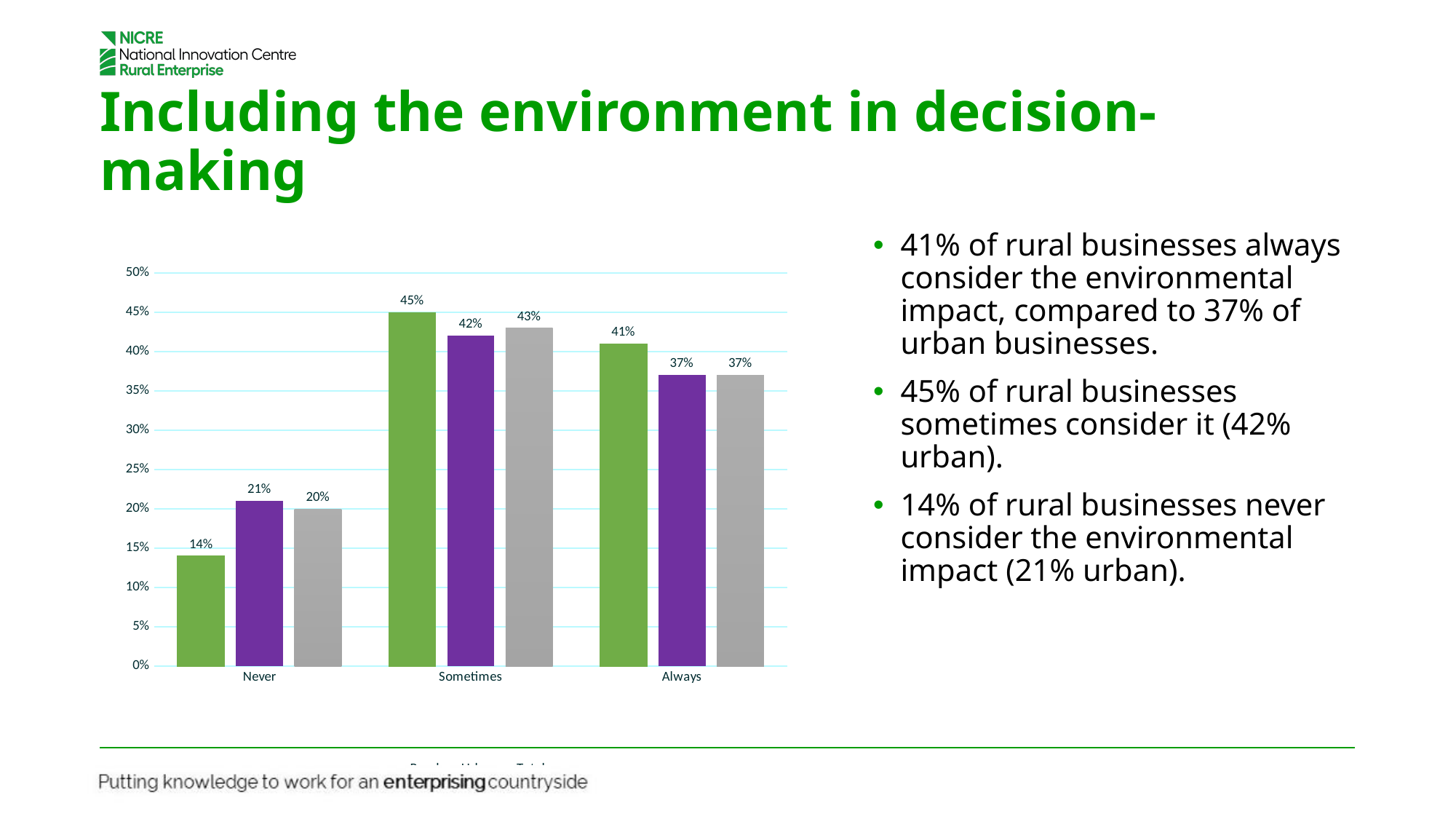
In the Never category, which is larger: the green bar or the purple bar? the purple bar What is the value of the grey bar for the Sometimes category? 43% What is the difference between the purple bar and the green bar in the Never category? 7% What is the value of the purple bar for the Never category? 21% What type of chart is shown on the slide? bar chart What is the difference between the green bar and the purple bar in the Always category? 4% What is the value of the green bar for the Sometimes category? 45% Which category has the highest value for the purple bar? Sometimes Which category has the lowest value for the green bar? Never What is the value of the grey bar for the Always category? 37% What is the highest value shown on the y axis of the chart? 50% How many categories are shown on the x axis of the chart? 3